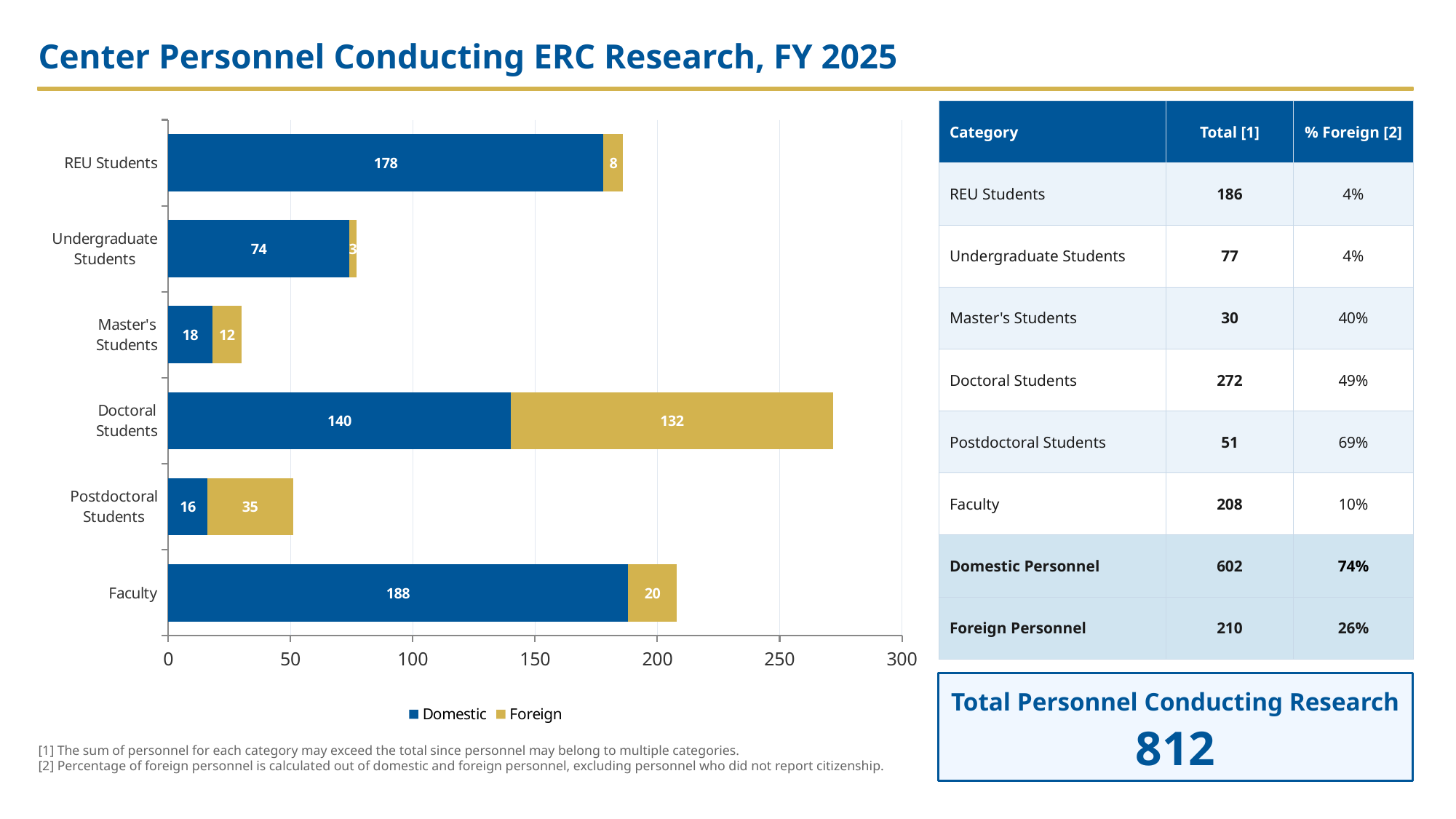
What is the Foreign value for Faculty? 20 What is the Foreign value for Postdoctoral Students? 35 What kind of chart is shown on the slide? Stacked bar chart What is the difference between the Domestic and Foreign values for Doctoral Students? 8 What is the total of the stacked bar for REU Students? 186 Which is larger for Master's Students, the Domestic value or the Foreign value? Domestic Which series is shown in gold on the chart? Foreign What is the Domestic value for Doctoral Students? 140 Which category has the lowest Foreign value? Undergraduate Students How many series does the legend list? 2 Which category has the highest Domestic value? Faculty How many categories are shown on the chart? 6